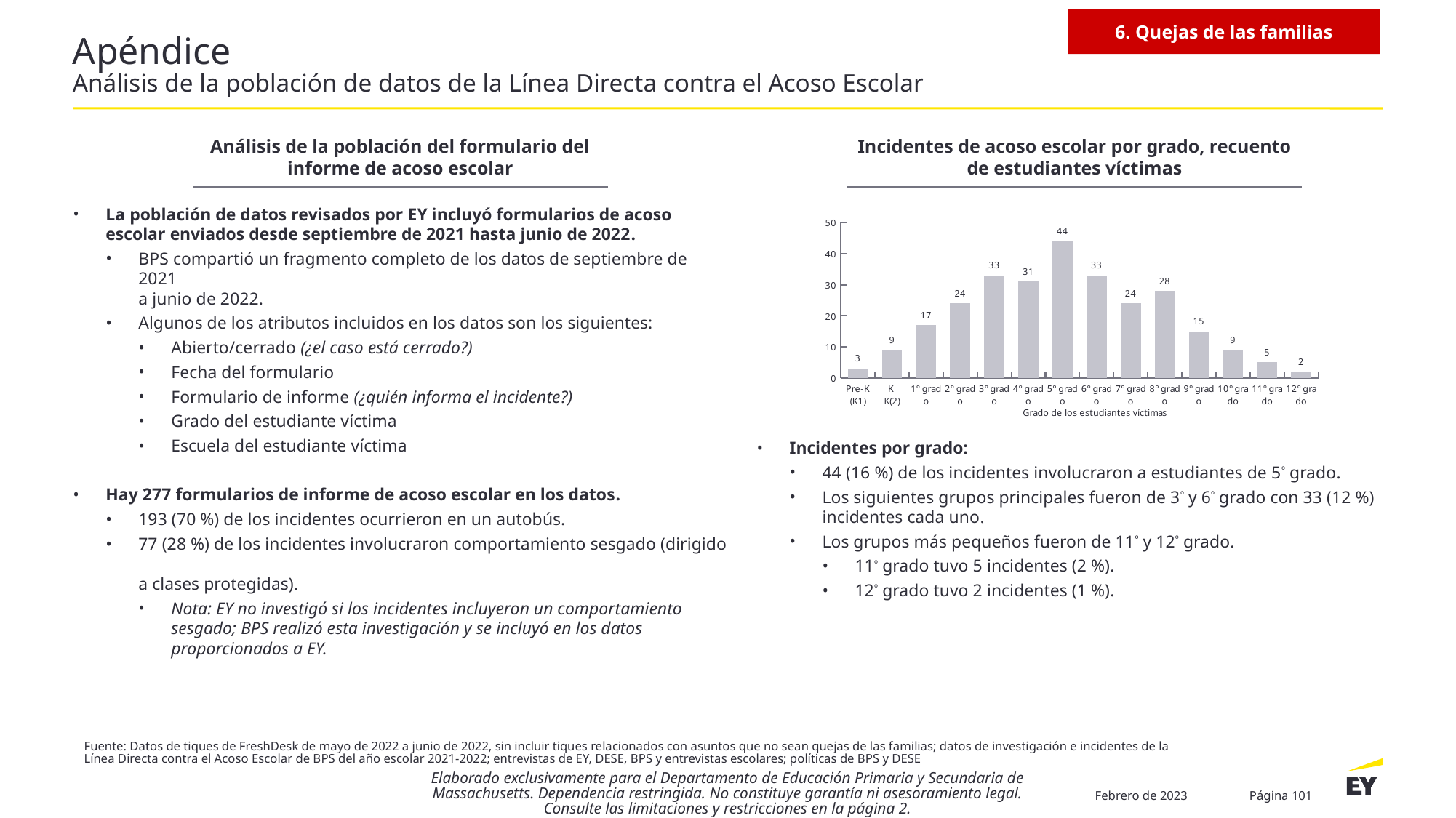
What is the number of victim students for 8° grado? 28 What is the difference between the values for 5° grado and 4° grado? 13 What type of chart is shown on the slide? Bar chart Do the values rise or fall from 9° grado to 12° grado? Fall How many grade categories are plotted in the chart? 14 Is the value for 3° grado greater or less than 30? greater What is the title of the chart? Incidentes de acoso escolar por grado, recuento de estudiantes víctimas What is the number of victim students for Pre-K (K1)? 3 What is the number of victim students for 5° grado? 44 Which grade has the highest number of victim students? 5° grado Which grade has the lowest number of victim students? 12° grado Which has a larger value, 9° grado or 10° grado? 9° grado